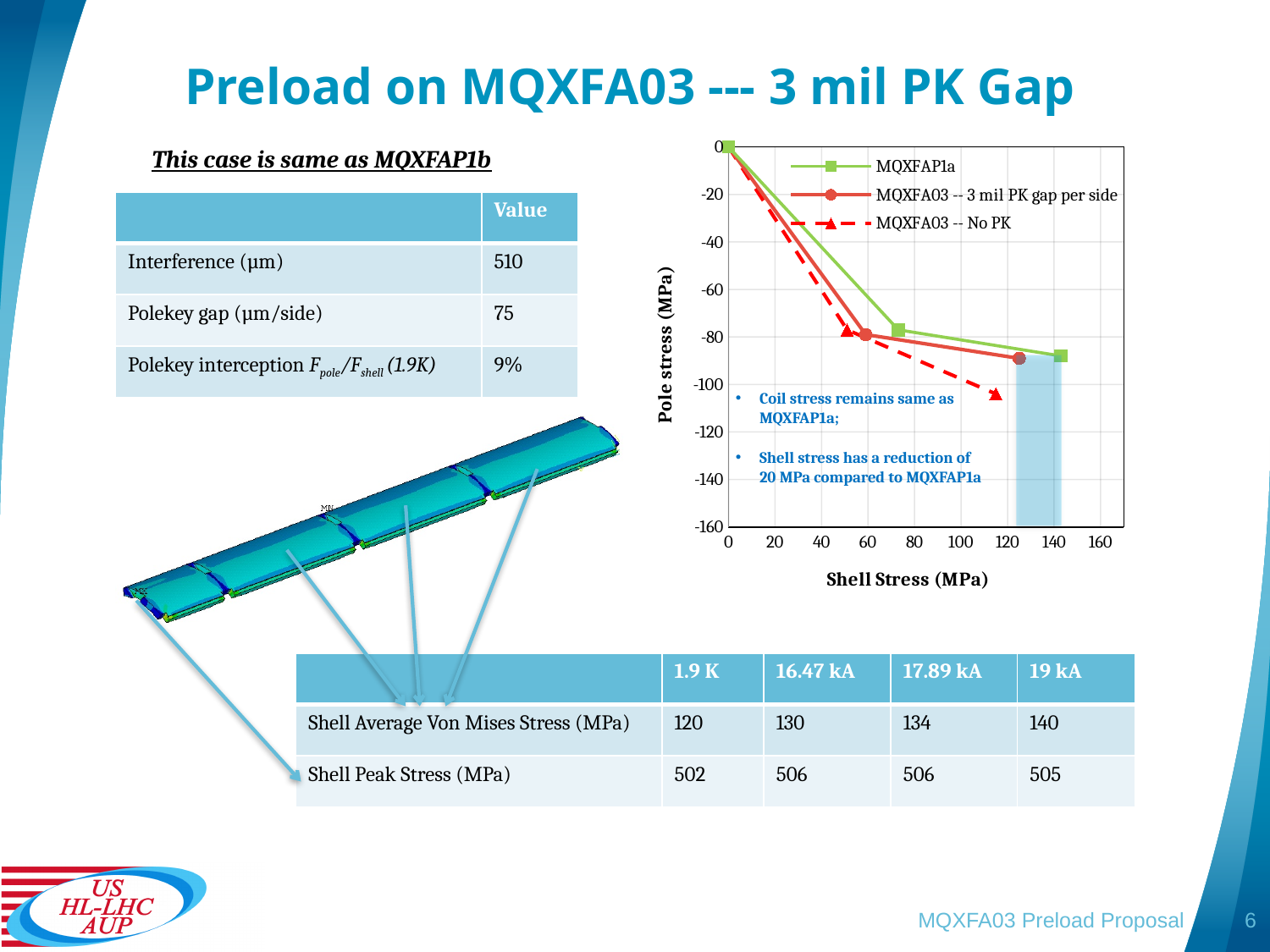
Which series is drawn with a dashed line in the chart? MQXFA03 -- No PK What is the title of the x axis of the chart? Shell Stress (MPa) Is the pole stress of the last point of the MQXFA03 -- 3 mil PK gap per side series greater or less than -80? less Is the shell stress of the last point of the MQXFAP1a series greater or less than 120? greater As shell stress increases along the x axis, does the pole stress rise or fall? fall Which series reaches the lowest (most negative) pole stress on the chart? MQXFA03 -- No PK What kind of chart is shown on the slide? line chart How many series does the chart legend list? 3 Which series reaches the highest shell stress value on the chart? MQXFAP1a Is the pole stress of the last point of the MQXFA03 -- No PK series greater or less than -100? less Which series ends at a larger shell stress: MQXFA03 -- 3 mil PK gap per side or MQXFA03 -- No PK? MQXFA03 -- 3 mil PK gap per side